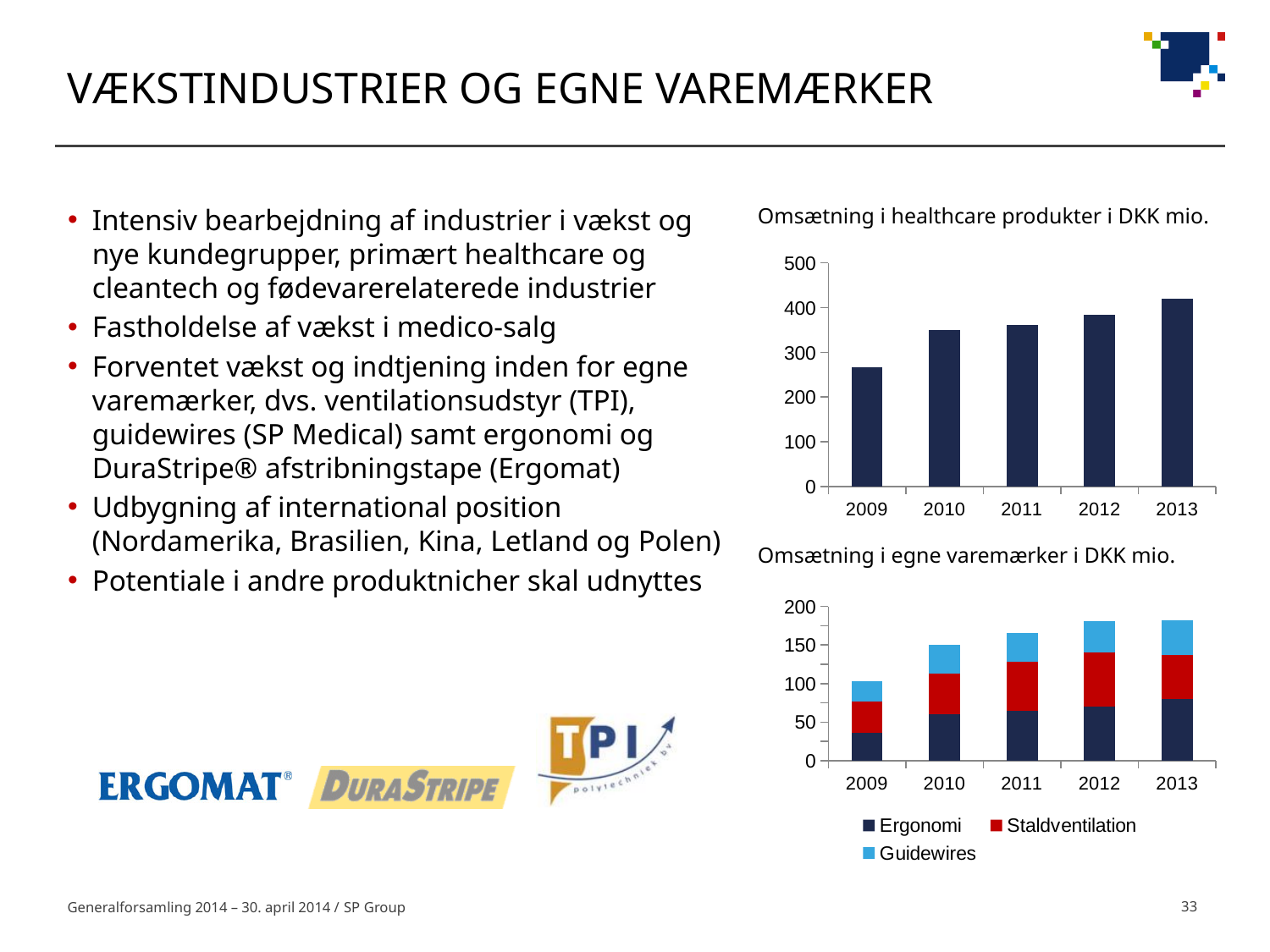
In the chart titled 'Omsætning i healthcare produkter i DKK mio.', do the values rise or fall from 2009 to 2013? rise In the chart titled 'Omsætning i egne varemærker i DKK mio.', is the total for 2013 greater or less than 150? greater In the chart titled 'Omsætning i healthcare produkter i DKK mio.', which year has the highest value? 2013 In the chart titled 'Omsætning i egne varemærker i DKK mio.', which year has the lowest total bar? 2009 In the chart titled 'Omsætning i healthcare produkter i DKK mio.', is the value for 2013 greater or less than 400? greater In the chart titled 'Omsætning i healthcare produkter i DKK mio.', what kind of chart is shown? bar chart In the chart titled 'Omsætning i egne varemærker i DKK mio.', which series is shown in red? Staldventilation In the chart titled 'Omsætning i egne varemærker i DKK mio.', how many series does the legend list? 3 In the chart titled 'Omsætning i egne varemærker i DKK mio.', is the Ergonomi value for 2013 greater or less than 50? greater In the chart titled 'Omsætning i healthcare produkter i DKK mio.', how many years are shown on the x axis? 5 In the chart titled 'Omsætning i healthcare produkter i DKK mio.', which year has the lowest value? 2009